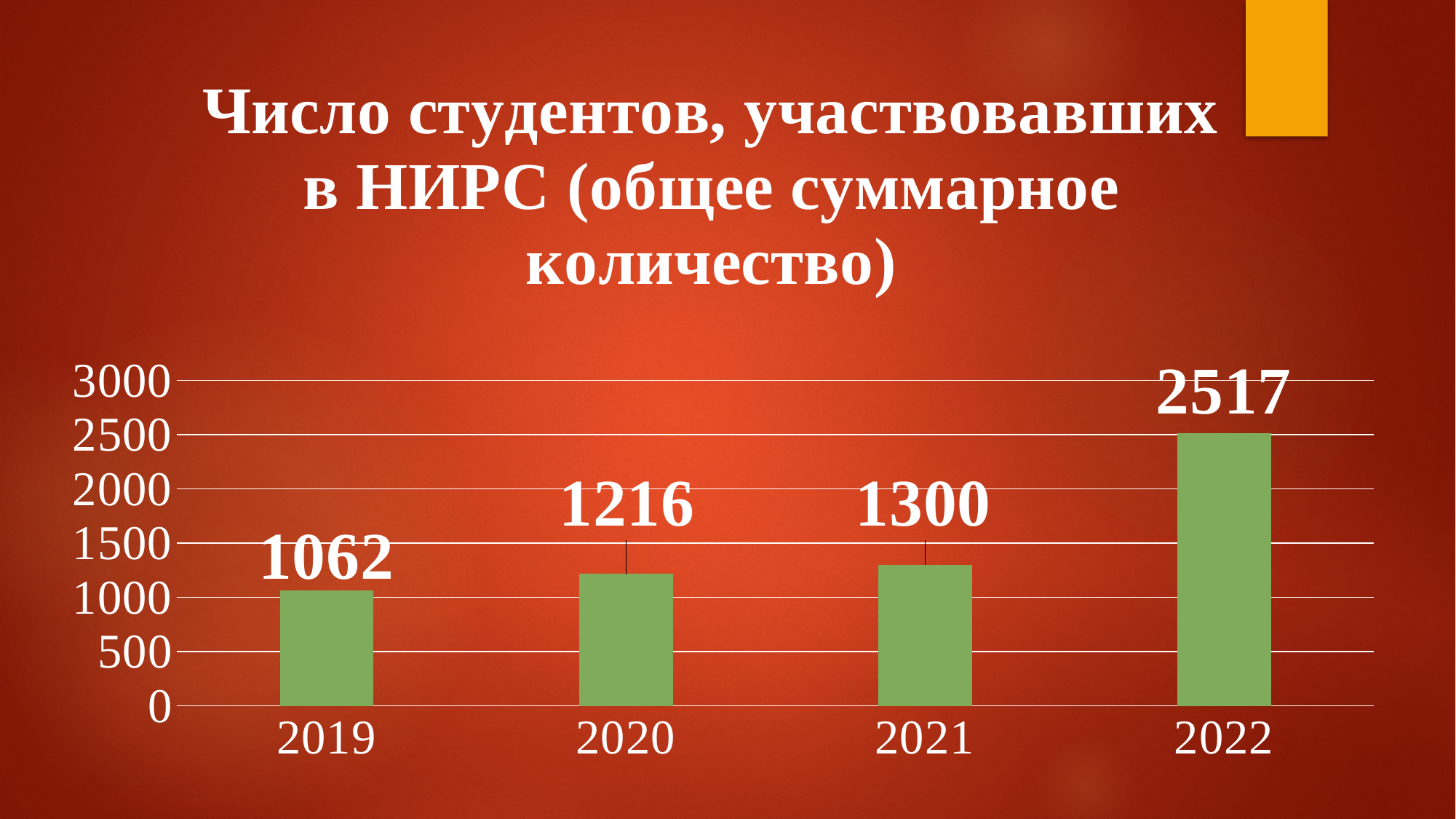
Which is larger, the value for 2021 or the value for 2020? 2021 What is the difference between the values for 2020 and 2019? 154 How many years are shown on the x axis? 4 What kind of chart is shown on the slide? bar chart What is the value for 2021? 1300 Which year has the lowest value? 2019 Is the value for 2022 greater or less than 2000? greater Which year has the highest value? 2022 What is the difference between the values for 2022 and 2021? 1217 What is the value for 2019? 1062 What is the value for 2020? 1216 What is the value for 2022? 2517